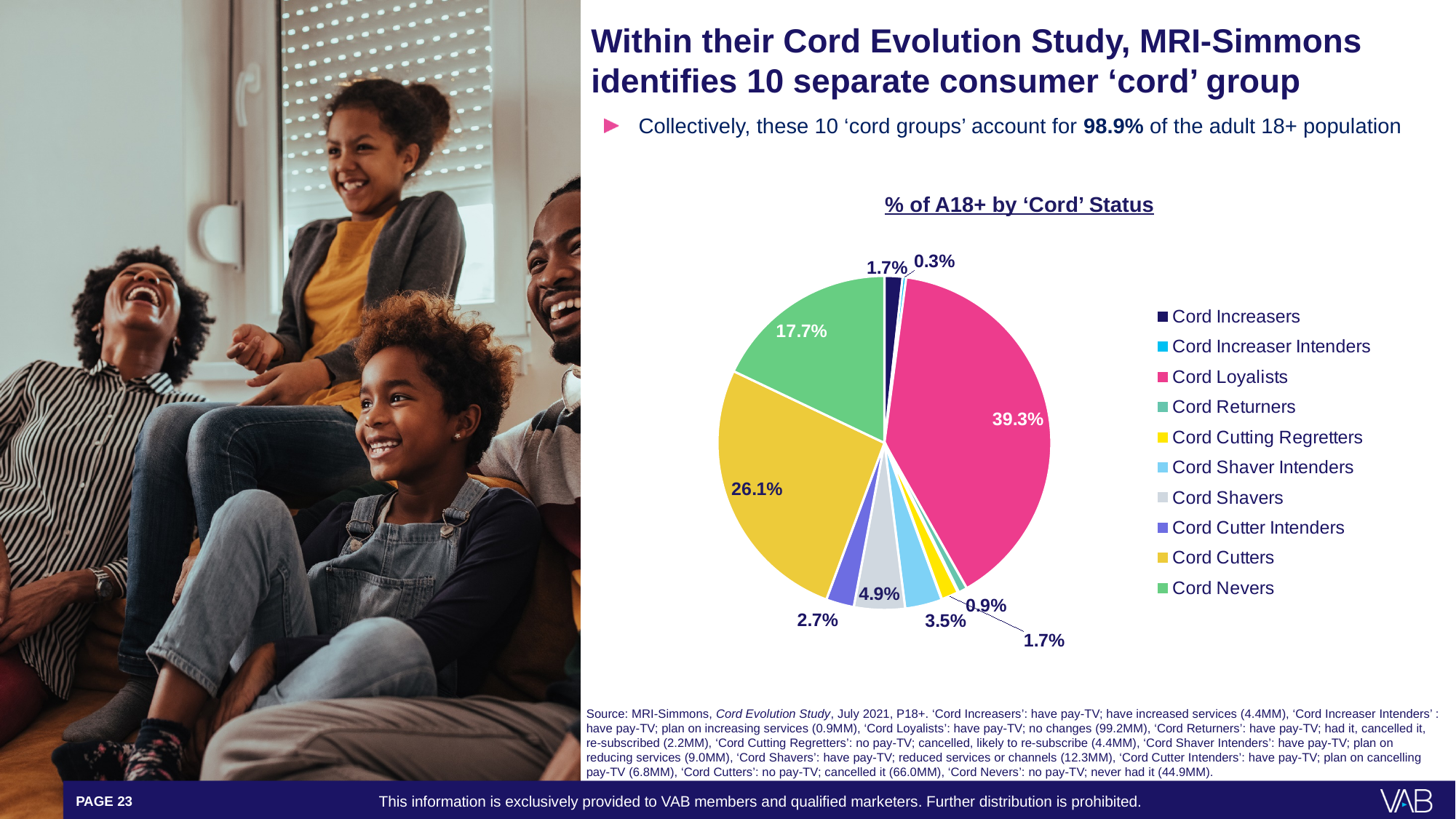
What is the difference in percentage points between Cord Loyalists and Cord Cutters? 13.2 What is the title of the chart? % of A18+ by 'Cord' Status What percentage of A18+ are Cord Nevers? 17.7% Which cord group has the smallest share of the pie? Cord Increaser Intenders What percentage of A18+ are Cord Increaser Intenders? 0.3% Which is larger, the share for Cord Nevers or the share for Cord Cutters? Cord Cutters How many categories does the legend of the pie chart list? 10 What type of chart is shown on the slide? Pie chart What percentage of A18+ are Cord Loyalists? 39.3% What percentage of A18+ are Cord Cutters? 26.1% What percentage of A18+ are Cord Shavers? 4.9% Which cord group has the largest share of the pie? Cord Loyalists